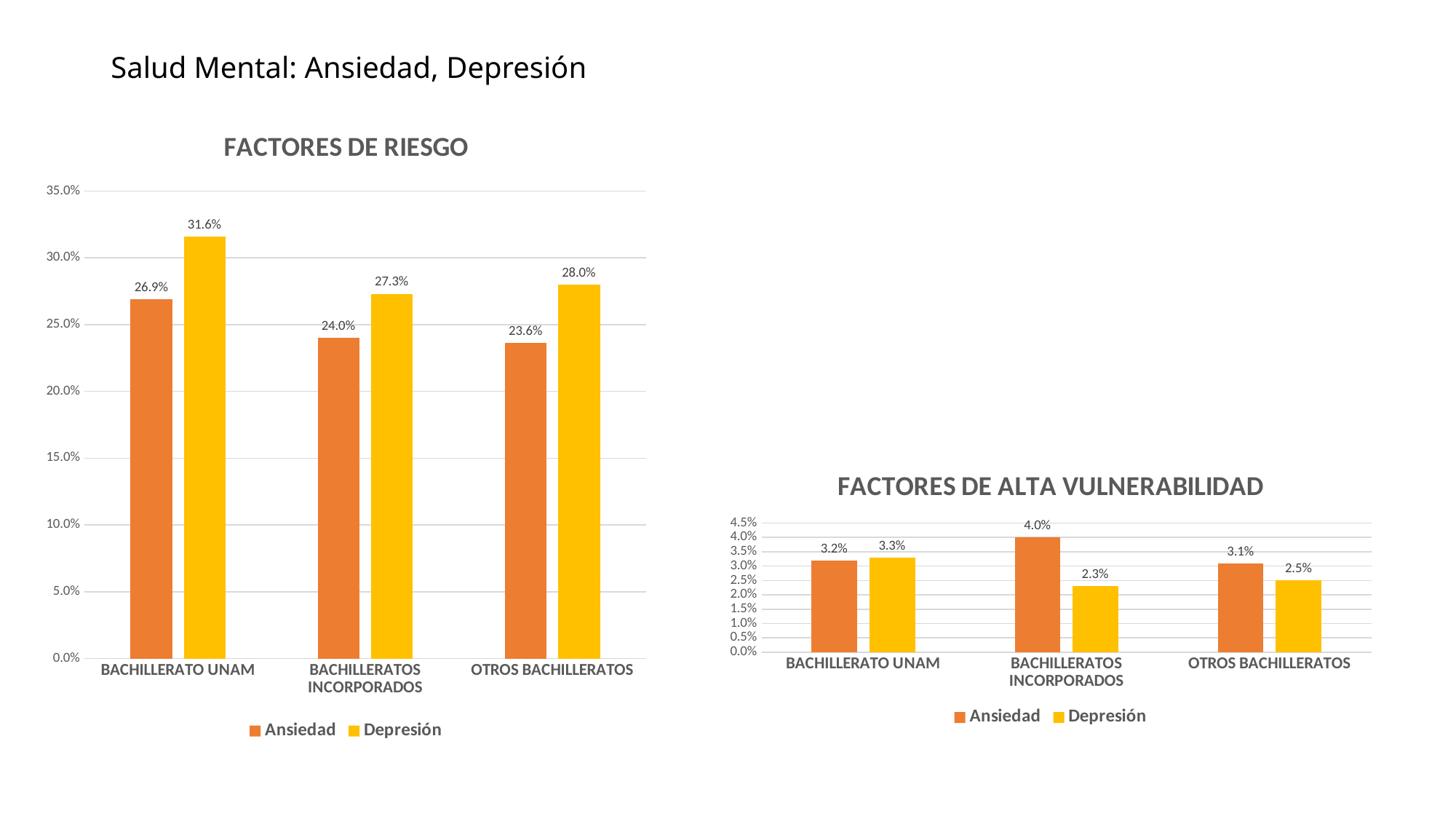
In the 'FACTORES DE ALTA VULNERABILIDAD' chart, what is the Depresión value for OTROS BACHILLERATOS? 2.5% In the 'FACTORES DE ALTA VULNERABILIDAD' chart, is the Ansiedad value for BACHILLERATOS INCORPORADOS larger or the Depresión value? Ansiedad What kind of chart is 'FACTORES DE RIESGO'? Bar chart In the 'FACTORES DE RIESGO' chart, what is the Ansiedad value for OTROS BACHILLERATOS? 23.6% In the 'FACTORES DE RIESGO' chart, what is the Depresión value for BACHILLERATO UNAM? 31.6% In the 'FACTORES DE RIESGO' chart, how many categories are shown on the x axis? 3 In the 'FACTORES DE RIESGO' chart, which category has the highest Ansiedad value? BACHILLERATO UNAM In the 'FACTORES DE RIESGO' chart, which category has the lowest Depresión value? BACHILLERATOS INCORPORADOS In the 'FACTORES DE ALTA VULNERABILIDAD' chart, what is the Ansiedad value for BACHILLERATOS INCORPORADOS? 4.0% In the 'FACTORES DE ALTA VULNERABILIDAD' chart, which category has the lowest Depresión value? BACHILLERATOS INCORPORADOS In the 'FACTORES DE RIESGO' chart, what is the difference between the Depresión and Ansiedad values for BACHILLERATO UNAM? 4.7% How many series does the legend of the 'FACTORES DE ALTA VULNERABILIDAD' chart list? 2